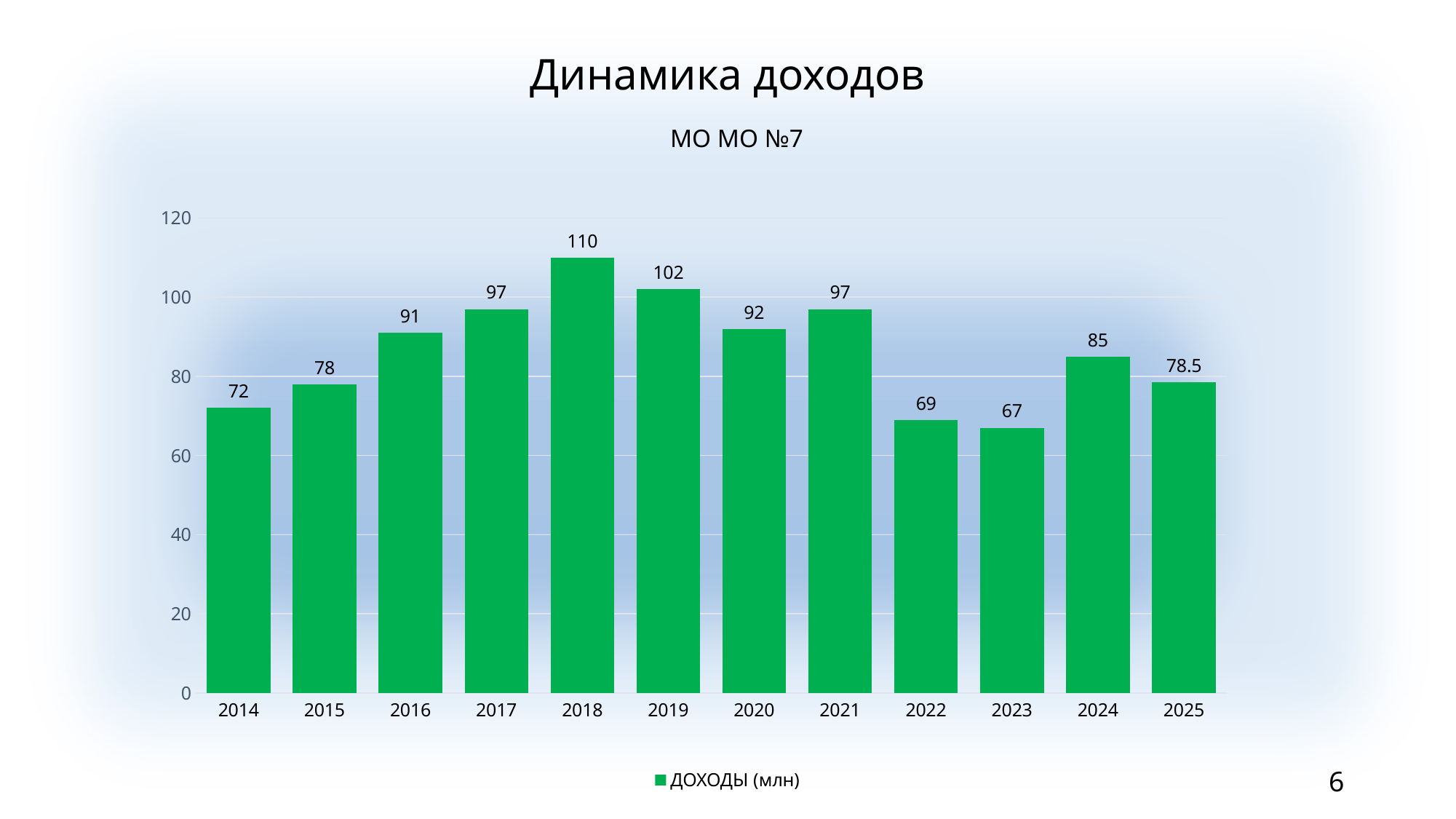
What is the value for 2014? 72 What is the legend entry of the chart? ДОХОДЫ (млн) What is the value for 2018? 110 How many years are shown on the x axis? 12 How many series does the legend list? 1 Is the value for 2022 greater or less than 80? less Which year has the lowest value? 2023 Which year has the highest value? 2018 What is the value for 2025? 78.5 What is the difference between the values for 2018 and 2023? 43 Which is larger, the value for 2019 or the value for 2021? 2019 What kind of chart is shown? bar chart